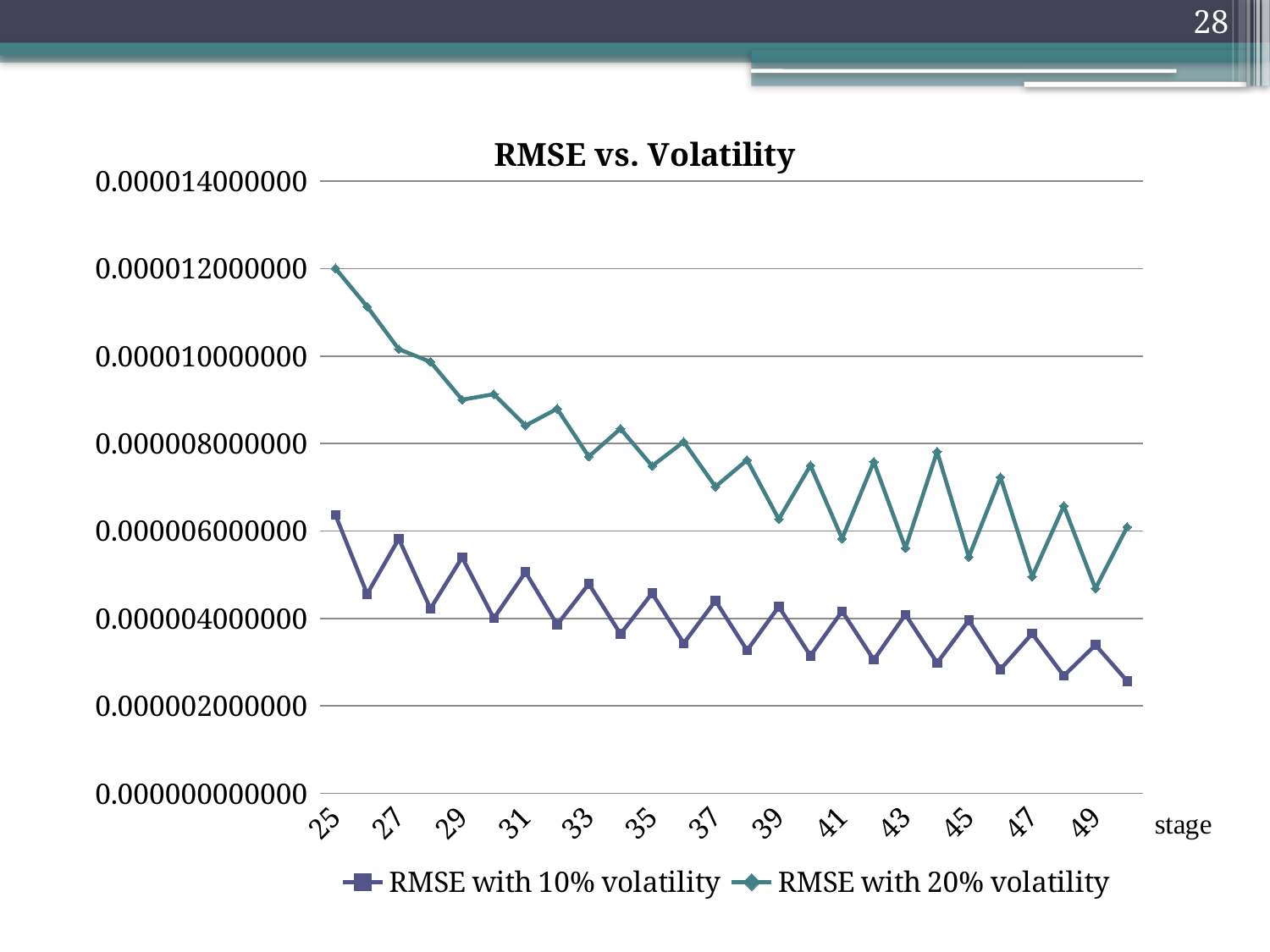
How many series does the legend list? 2 What label is shown on the x axis of the chart? stage Is the value for RMSE with 20% volatility at stage 25 greater or less than 0.000010000000? greater At stage 25, which series has the higher value: RMSE with 10% volatility or RMSE with 20% volatility? RMSE with 20% volatility What kind of chart is shown on the slide? line chart Is the value for RMSE with 10% volatility at stage 25 greater or less than 0.000008000000? less What is the title of the chart? RMSE vs. Volatility Is the value for RMSE with 20% volatility at stage 47 greater or less than 0.000006000000? less Overall, do the values for RMSE with 20% volatility rise or fall as the stage increases? fall At which stage is the value for RMSE with 20% volatility highest? 25 How many data points does each series have? 26